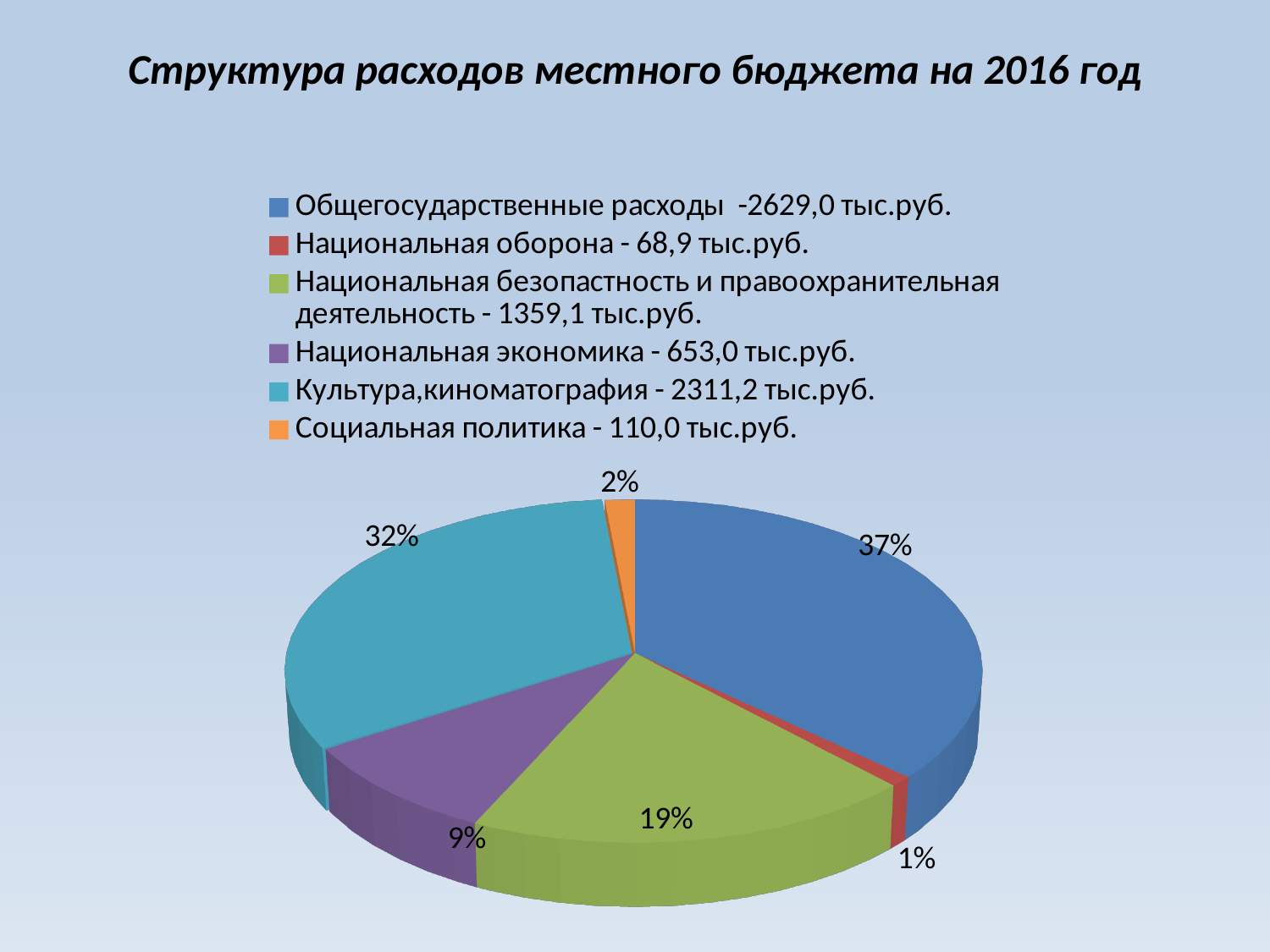
Which has a larger share: Национальная экономика or Национальная безопастность и правоохранительная деятельность? Национальная безопастность и правоохранительная деятельность Which category has the smallest share of the pie? Национальная оборона What is the title of the chart? Структура расходов местного бюджета на 2016 год What is the difference in percentage points between the shares of Общегосударственные расходы and Культура,киноматография? 5 What share of the pie does Общегосударственные расходы take? 37% How many slices does the pie chart have? 6 What share of the pie does Социальная политика take? 2% What share of the pie does Национальная безопастность и правоохранительная деятельность take? 19% What kind of chart is shown on the slide? pie chart Which category has the largest share of the pie? Общегосударственные расходы According to the legend, what is the amount for Национальная экономика? 653,0 тыс.руб.